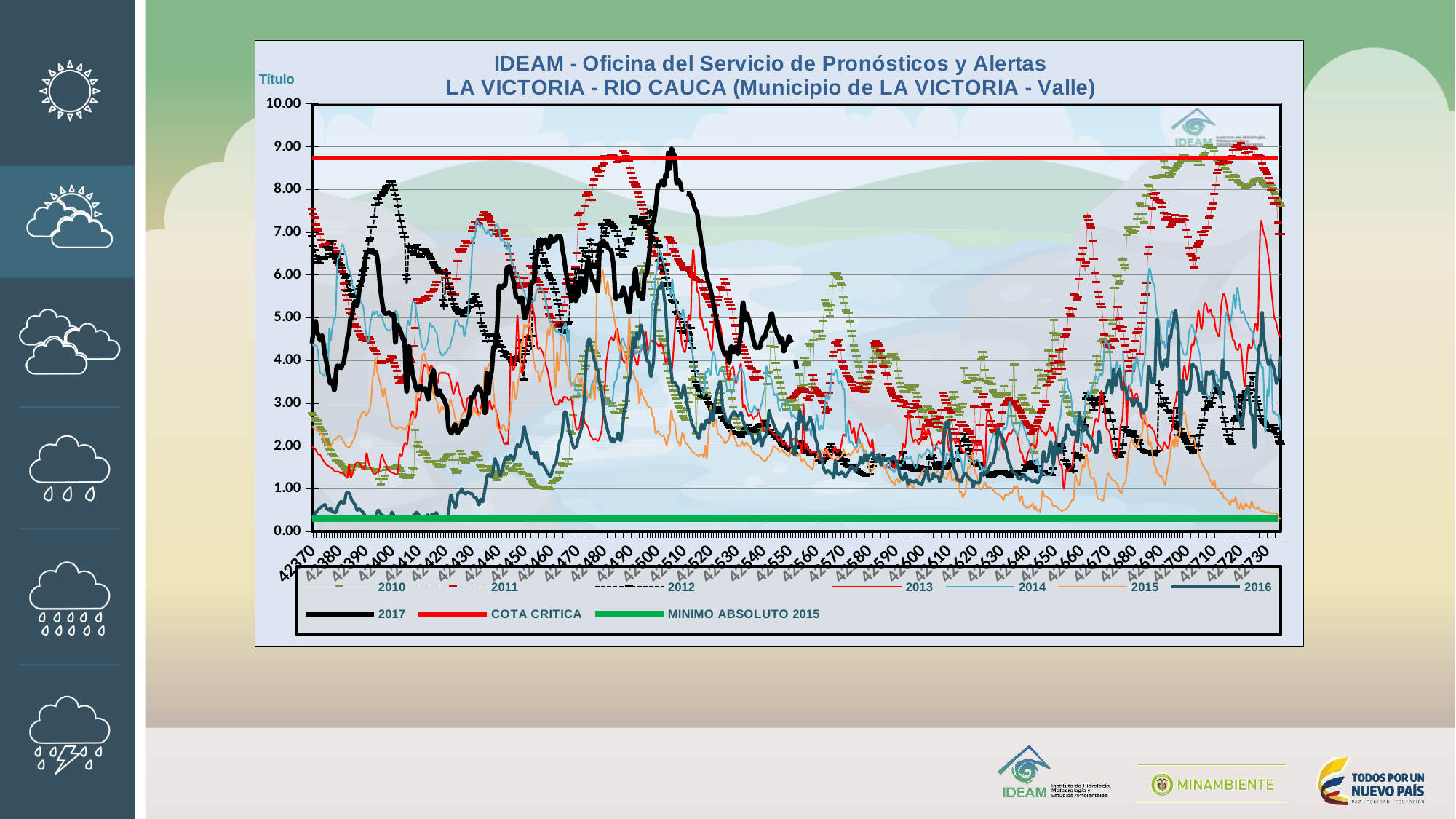
What kind of chart is shown on the slide? line chart How many series does the legend list? 10 Is the value of the 2017 series at 42510 greater or less than 8.00? greater At 42510, which series has the larger value, 2017 or 2015? 2017 Is the value of the COTA CRITICA line greater or less than 8.00? greater Which is higher, the COTA CRITICA line or the MINIMO ABSOLUTO 2015 line? COTA CRITICA How many labels are shown on the x axis? 37 Is the value of the 2015 series at 42730 greater or less than 1.00? less What is the highest value labelled on the y axis? 10.00 What is the second line of the chart title? LA VICTORIA - RIO CAUCA (Municipio de LA VICTORIA - Valle) What colour is the COTA CRITICA line? red